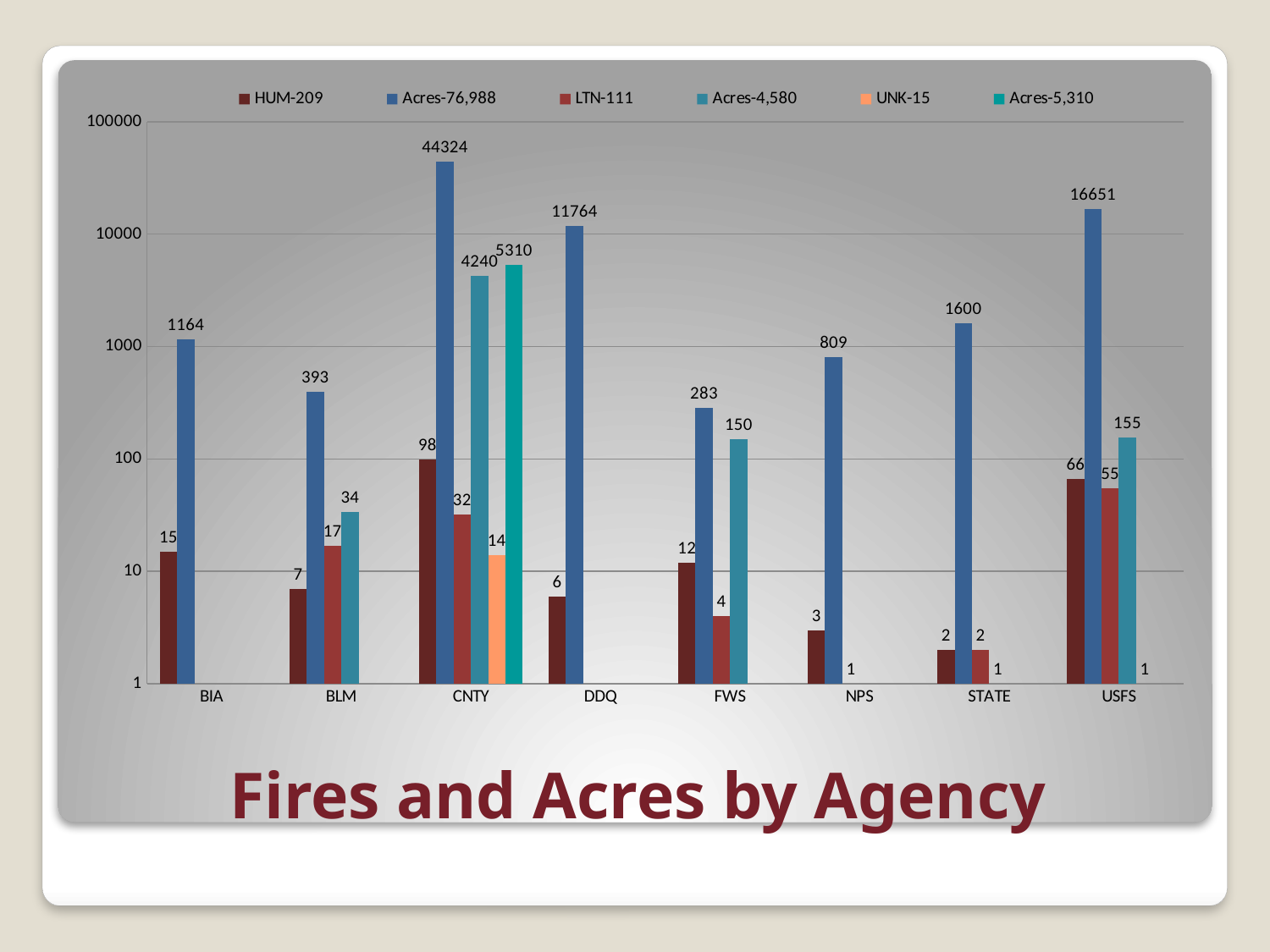
Which agency has the lowest HUM-209 value? STATE What is the UNK-15 value for CNTY? 14 What is the title of the chart? Fires and Acres by Agency What is the HUM-209 value for CNTY? 98 Which is larger, the HUM-209 value for USFS or the LTN-111 value for USFS? HUM-209 value for USFS How many agency categories are shown on the x axis? 8 What is the difference between the Acres-76,988 values for DDQ and BIA? 10600 What type of chart is shown on the slide? bar chart What is the LTN-111 value for BLM? 17 How many series does the legend list? 6 What is the Acres-76,988 value for USFS? 16651 Which agency has the highest Acres-76,988 value? CNTY